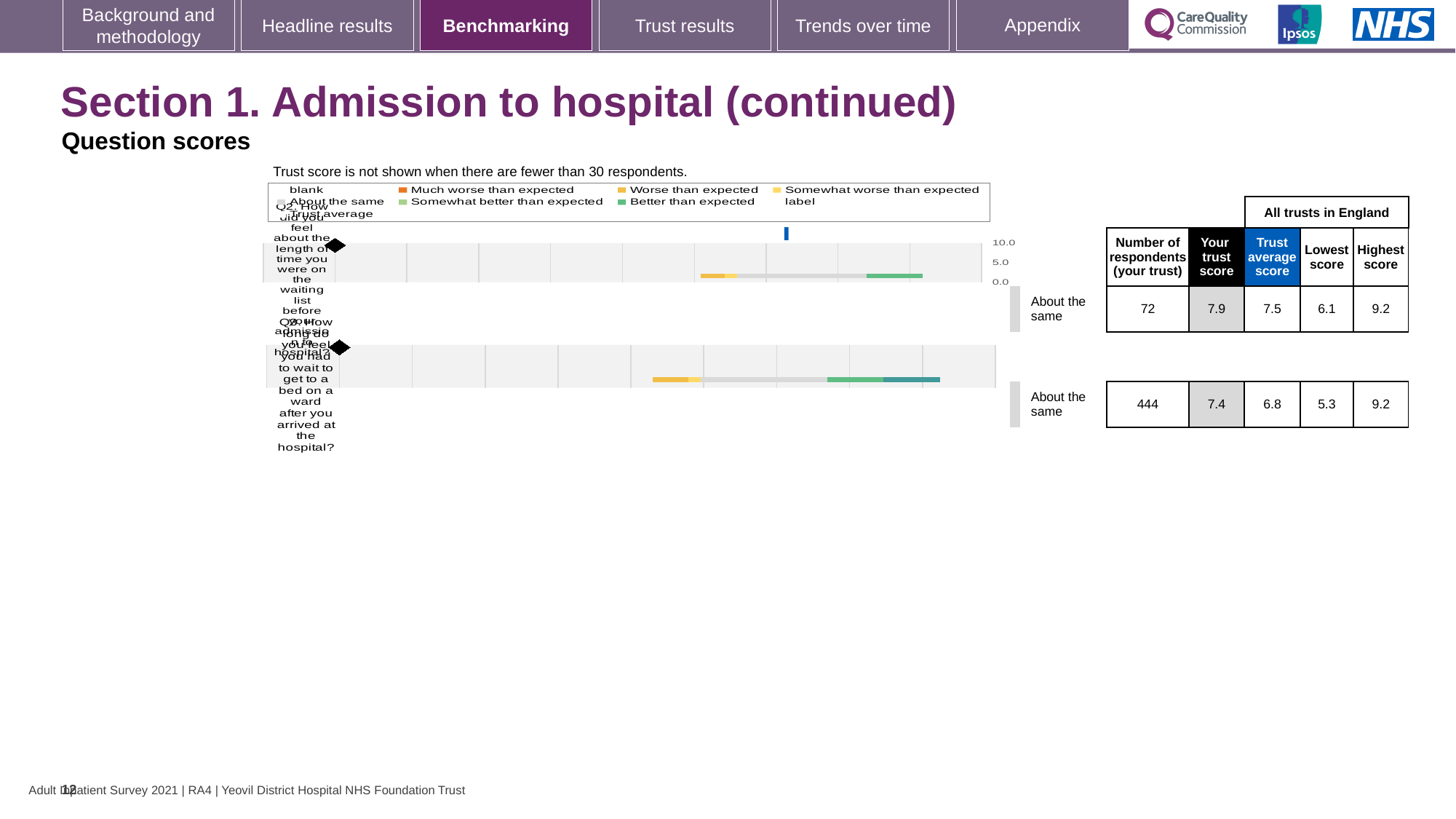
For Q3, how much higher is your trust score than the trust average score? 0.6 What is your trust score for Q3 (how long did you feel you had to wait to get to a bed on a ward after you arrived at the hospital)? 7.4 How many questions are charted on this slide? 2 For Q2, which is larger: your trust score or the trust average score? Your trust score How many respondents from your trust answered Q2 (how did you feel about the length of time you were on the waiting list before admission)? 72 For Q2, what is the difference between the highest score and the lowest score among all trusts in England? 3.1 What benchmark category label is shown next to the Q2 chart? About the same Which question had the larger number of respondents from your trust, Q2 or Q3? Q3 Is your trust score for Q3 greater or less than 5.0 on the chart axis? greater What is the trust average score across all trusts in England for Q2? 7.5 What is the lowest score among all trusts in England for Q3? 5.3 What kind of chart is used to show the question scores on this slide? Bar chart